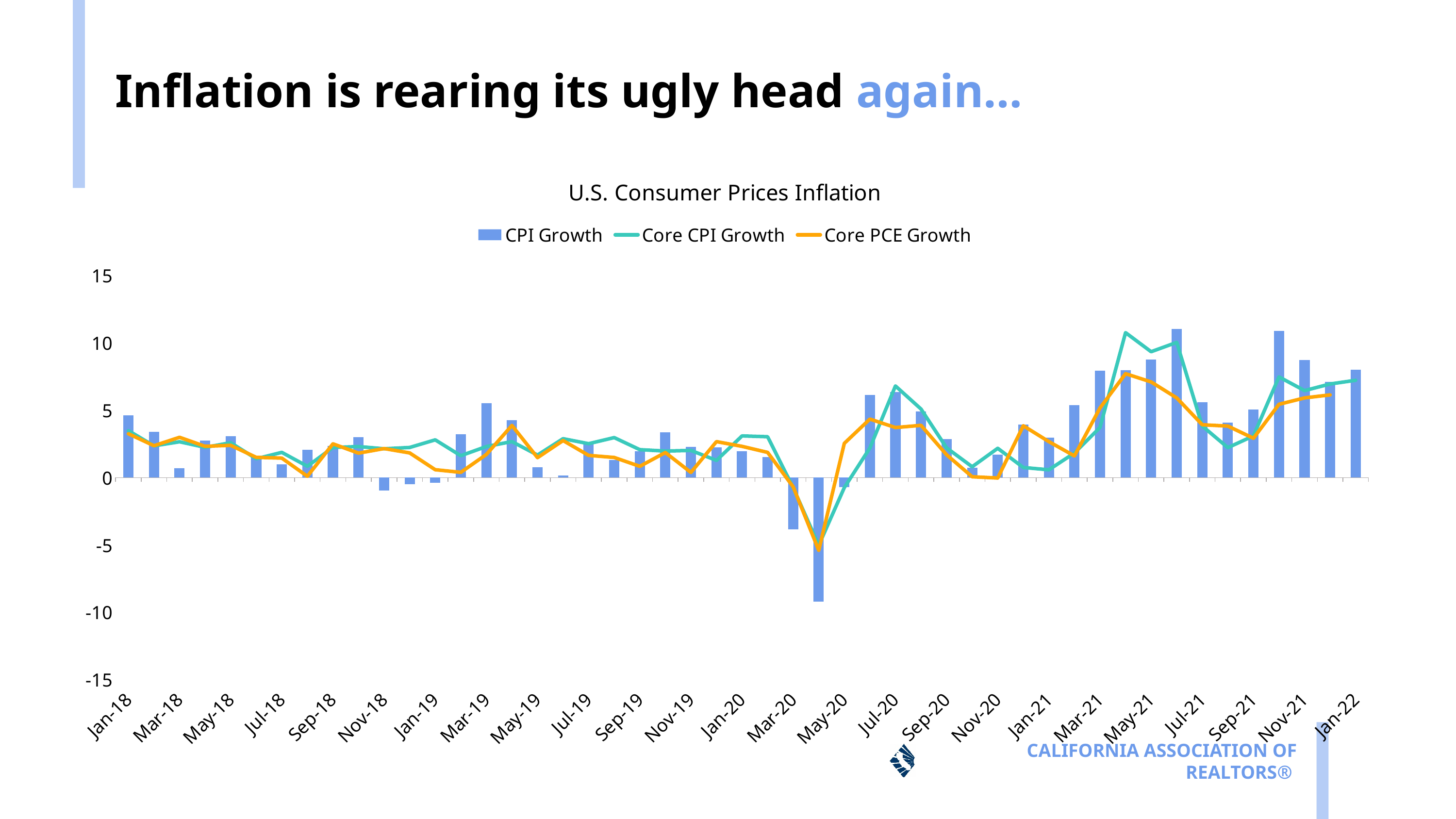
Is the CPI Growth value for Apr-20 greater or less than -5? less What kind of chart is this? Combined bar and line chart In which month is the CPI Growth bar lowest? Apr-20 Do the CPI Growth bars generally rise or fall from Apr-20 to Jun-21? rise Which is larger in Apr-21, Core CPI Growth or Core PCE Growth? Core CPI Growth Is the Core CPI Growth value for Apr-21 greater or less than 10? greater In which month does the Core PCE Growth line reach its lowest point? Apr-20 In which month does the Core CPI Growth line reach its highest point? Apr-21 Which series is drawn in orange? Core PCE Growth How many series does the chart's legend list? 3 Is the CPI Growth value for Jan-22 greater or less than 5? greater What is the title of the chart? U.S. Consumer Prices Inflation